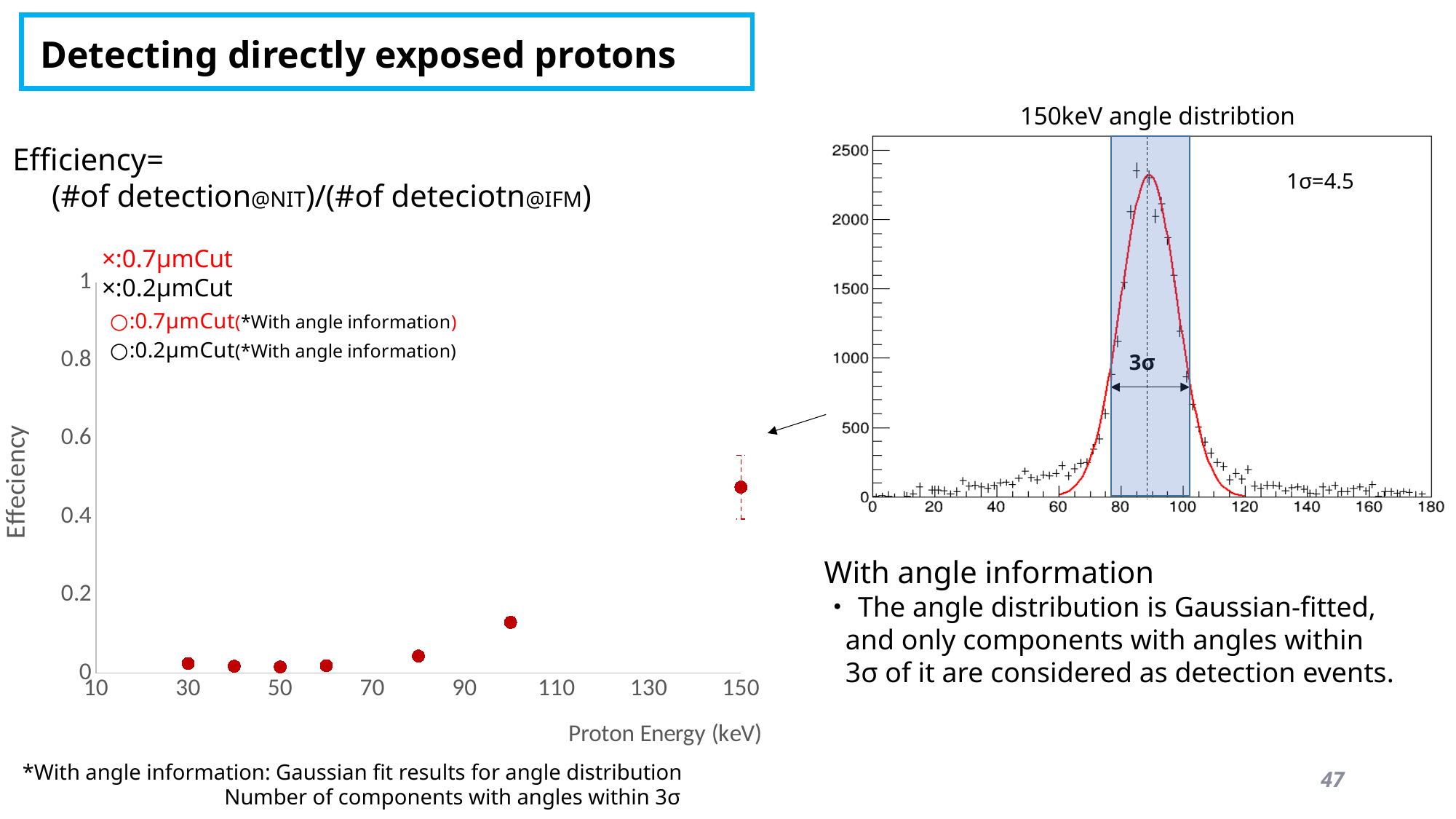
What kind of chart is the Efficiency vs Proton Energy chart on the left? scatter plot In the 150keV angle distribution chart on the right, what is the value of 1σ given on the chart? 1σ=4.5 In the Efficiency vs Proton Energy chart on the left, at which proton energy is the efficiency highest? 150 keV In the Efficiency vs Proton Energy chart on the left, what is the label of the x axis? Proton Energy (keV) In the Efficiency vs Proton Energy chart on the left, is the efficiency at 150 keV greater or less than 0.4? greater In the Efficiency vs Proton Energy chart on the left, does the efficiency generally rise or fall as proton energy increases from 60 keV to 150 keV? rise In the 150keV angle distribution chart on the right, is the value at an angle of 140 greater or less than 500? less In the 150keV angle distribution chart on the right, is the peak of the fitted curve greater or less than 2000? greater In the Efficiency vs Proton Energy chart on the left, which has the larger efficiency: 100 keV or 80 keV? 100 keV What is the title of the chart on the right? 150keV angle distribtion In the Efficiency vs Proton Energy chart on the left, how many data points are plotted? 7